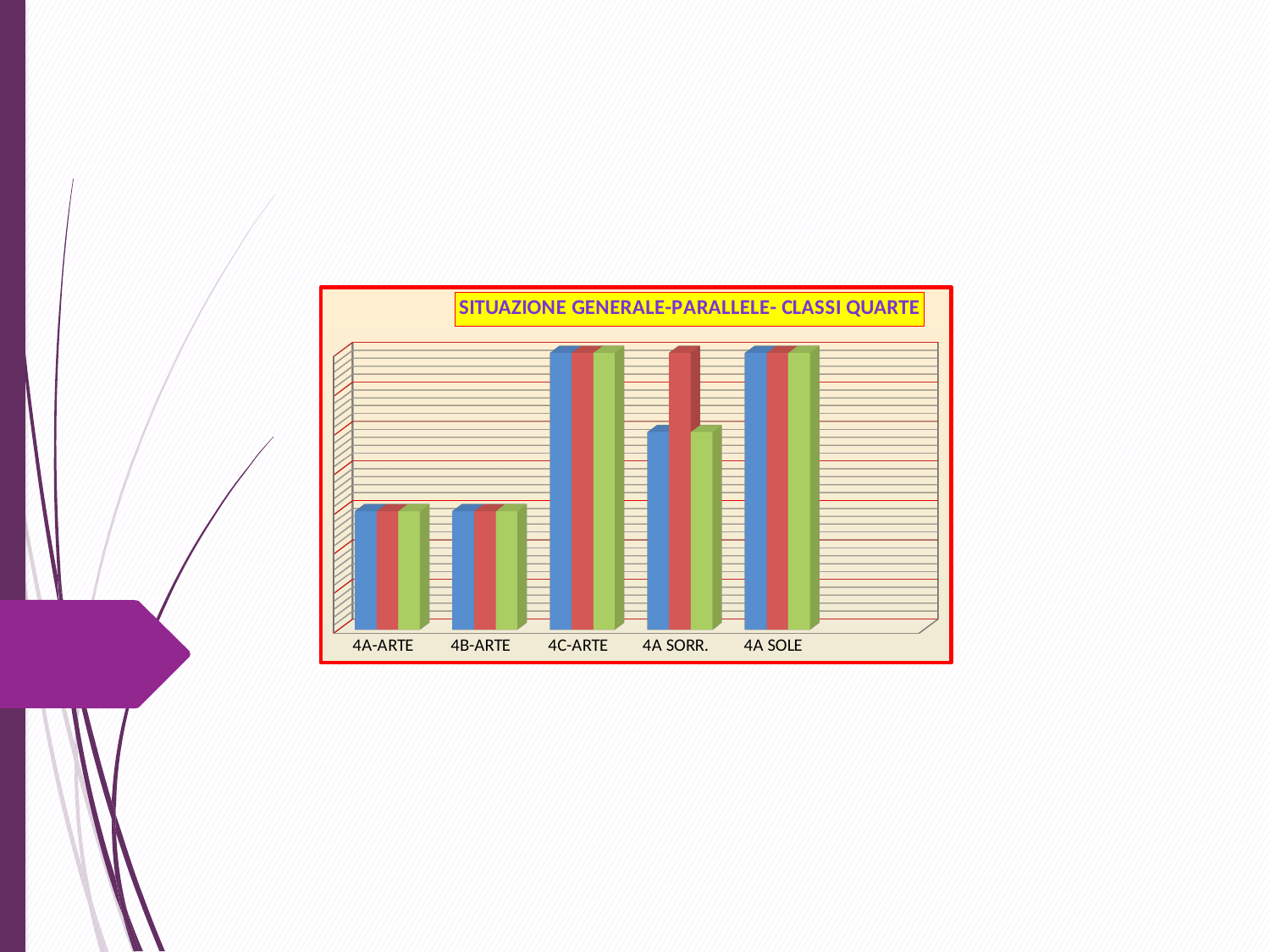
What kind of chart is shown on the slide? bar chart How many categories are shown on the x axis of the chart? 5 For 4A SORR., which is taller, the red bar or the blue bar? the red bar How many bars are plotted for each category in the chart? 3 Which category is labelled first on the x axis of the chart? 4A-ARTE Which is larger, the blue bar for 4C-ARTE or the blue bar for 4A-ARTE? 4C-ARTE Which is larger, the blue bar for 4A SOLE or the blue bar for 4A SORR.? 4A SOLE What is the title of the chart? SITUAZIONE GENERALE-PARALLELE- CLASSI QUARTE